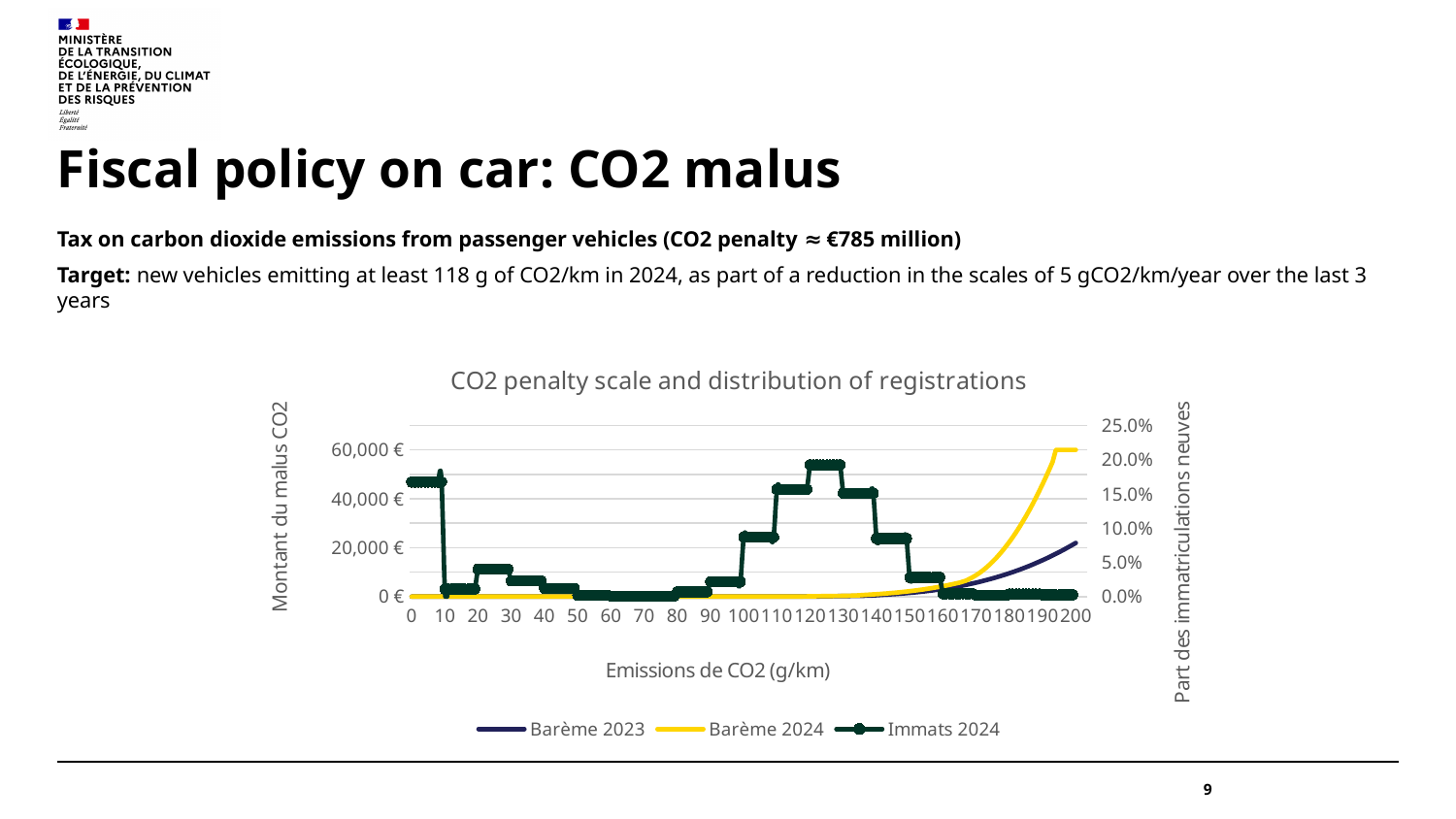
What is the x-axis title of the chart? Emissions de CO2 (g/km) Is the Barème 2024 value at 200 g/km greater or less than 40,000 €? greater How many series does the chart legend list? 3 Which series is drawn in yellow in the chart? Barème 2024 Does the Barème 2024 line rise or fall as CO2 emissions increase along the x axis? rise Is the Immats 2024 share at 60 g/km greater or less than 5.0%? less What kind of chart is shown on the slide? line chart Is the Barème 2023 value at 200 g/km greater or less than 40,000 €? less At 200 g/km, which series has the higher malus amount: Barème 2023 or Barème 2024? Barème 2024 What is the title of the chart? CO2 penalty scale and distribution of registrations Which emission range has the highest share of Immats 2024? 120–130 g/km